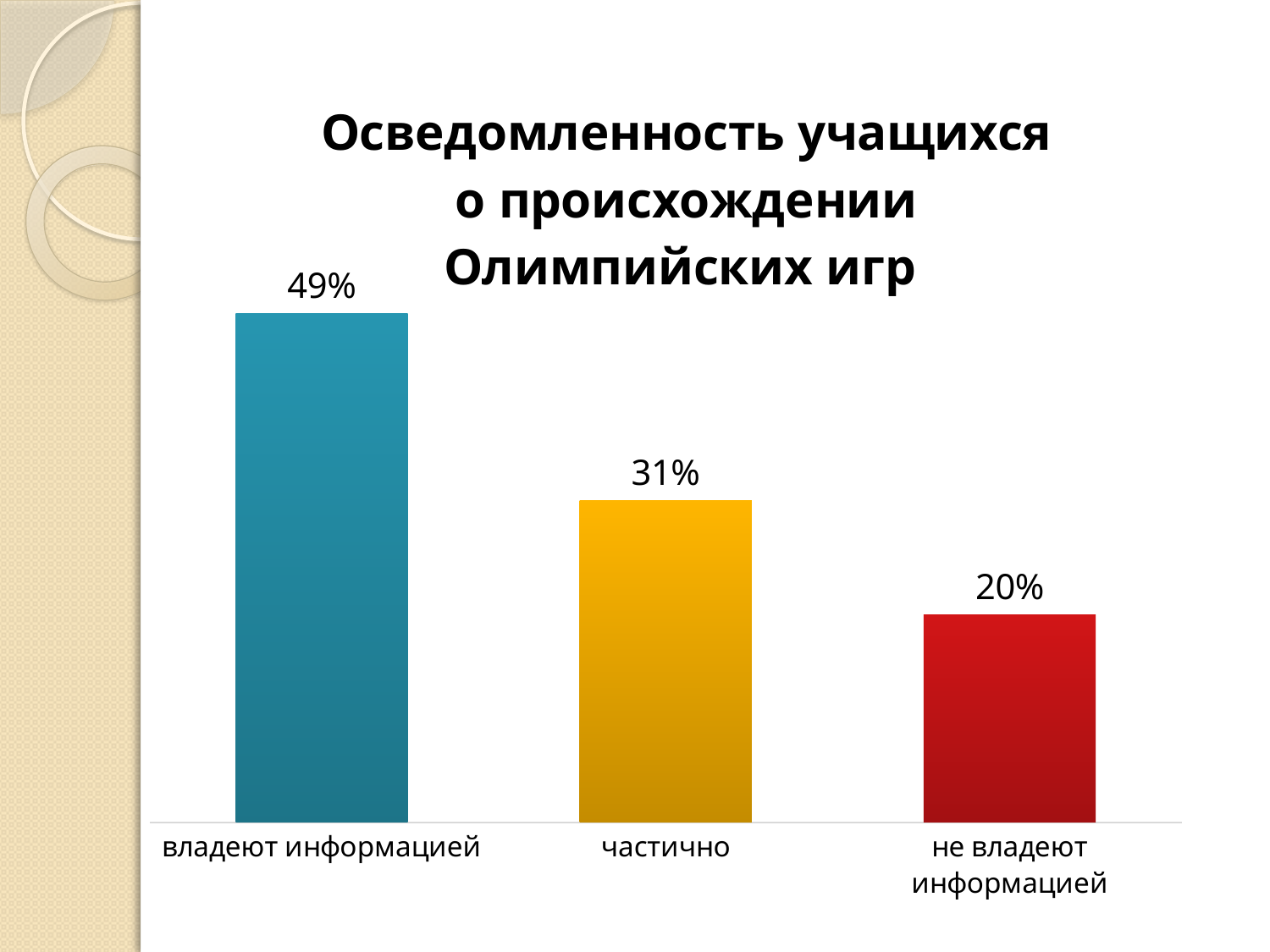
What kind of chart is shown on the slide? bar chart Which category has the lowest value? не владеют информацией Which category has the highest value? владеют информацией How many categories are shown in the chart? 3 What is the difference between the values for "частично" and "не владеют информацией"? 11% What is the value for "частично"? 31% What is the title of the chart? Осведомленность учащихся о происхождении Олимпийских игр Which is larger: the value for "частично" or the value for "не владеют информацией"? частично Do the values rise or fall from left to right across the categories? fall What is the difference between the values for "владеют информацией" and "частично"? 18% What is the value for "не владеют информацией"? 20% What is the value for "владеют информацией"? 49%